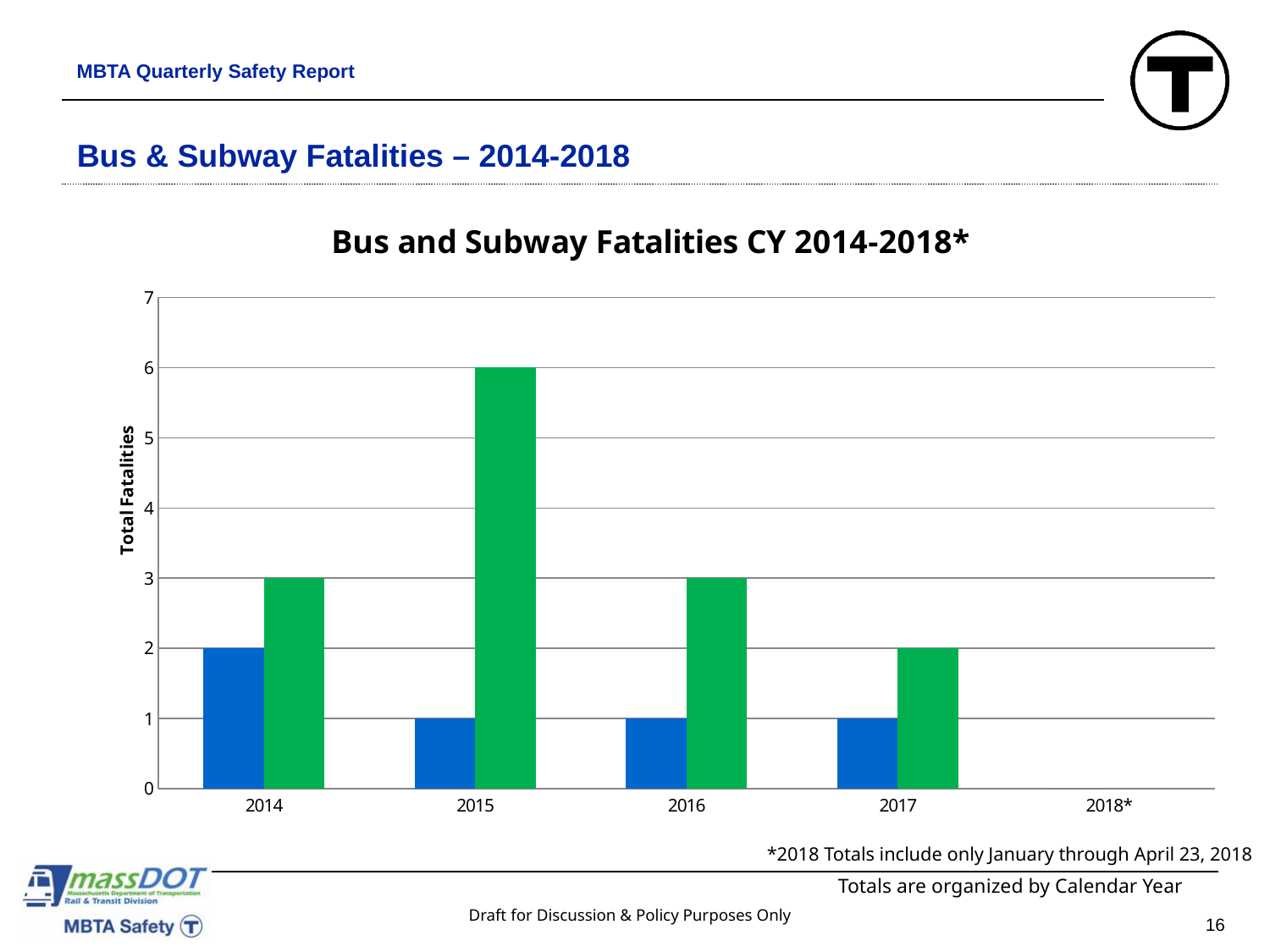
What is the value of the blue bar for 2016? 1 Is the green bar for 2014 larger or smaller than the green bar for 2017? larger What is the difference between the green bar and the blue bar for 2015? 5 What is the value of the green bar for 2015? 6 What is the value of the blue bar for 2014? 2 Which year has the tallest blue bar? 2014 What is the title of the chart? Bus and Subway Fatalities CY 2014-2018* What is the value of the green bar for 2017? 2 How many year categories are shown on the x axis? 5 What is the label of the y axis? Total Fatalities What type of chart is shown on the slide? bar chart Which year has the tallest green bar? 2015